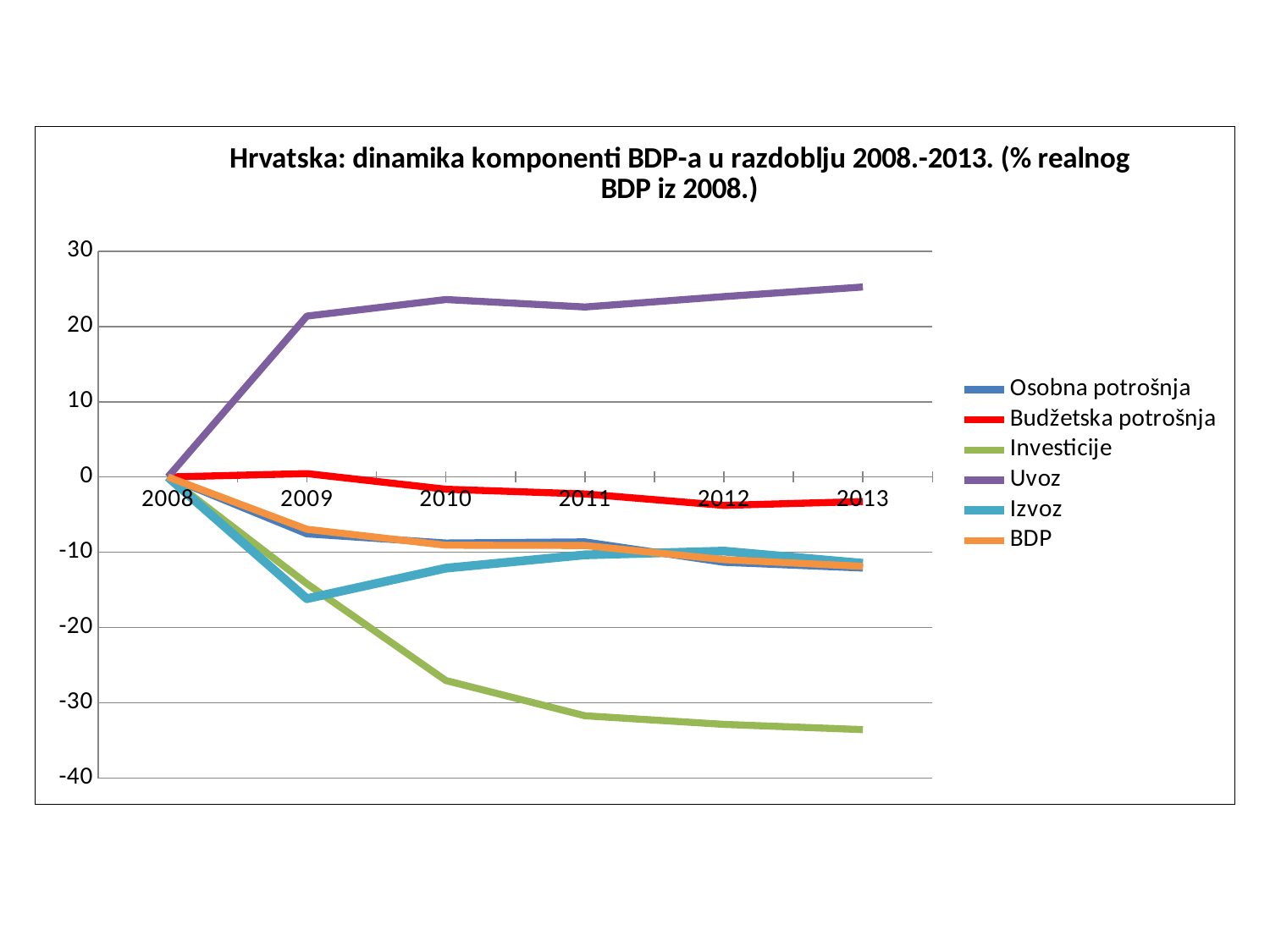
Is the value for Izvoz in 2009 greater or less than -10? less What type of chart is shown on the slide? line chart Which series has the lowest value in 2013? Investicije Which series has the highest value in 2013? Uvoz Does the value for Investicije rise or fall from 2008 to 2013? fall What is the value for Uvoz in 2008? 0 How many years are shown on the x axis? 6 Which is larger in 2010, the value for Uvoz or the value for Investicije? Uvoz Is the value for Investicije in 2013 greater or less than -30? less Which series is drawn in red in the legend? Budžetska potrošnja Is the value for Uvoz in 2013 greater or less than 20? greater How many series does the legend list? 6